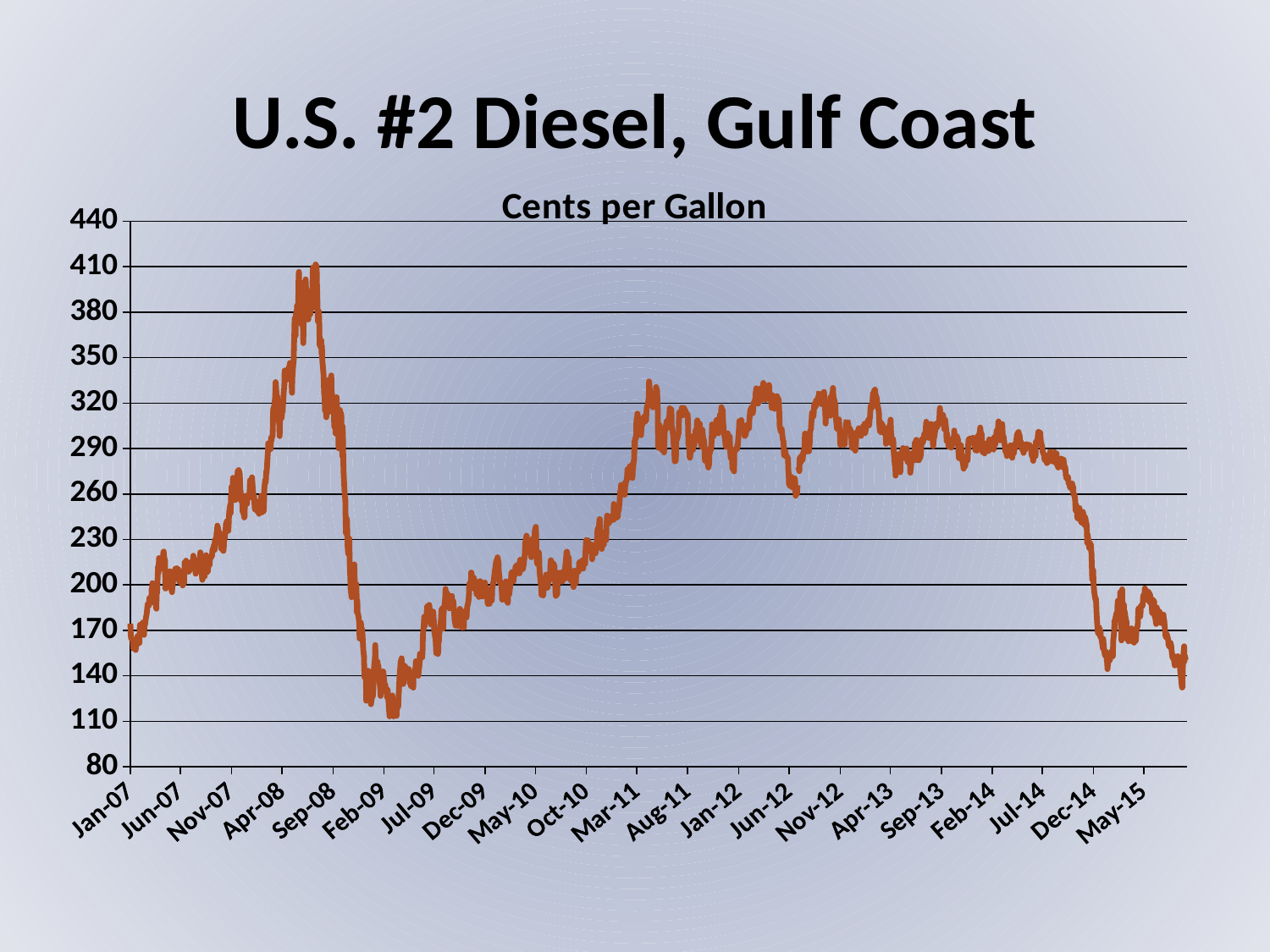
Is the peak value reached around Sep-08 greater or less than 380? greater What type of chart is shown on the slide? line chart Near which x-axis label does the line reach its lowest point? Feb-09 In what units are the values on the chart expressed? Cents per Gallon What is the title of the chart? U.S. #2 Diesel, Gulf Coast How many lines (data series) are plotted on the chart? 1 Is the lowest value reached in early 2009 greater or less than 140? less Is the value at Jan-12 greater or less than 260? greater Which is higher, the peak around Sep-08 or the peak around Aug-11? Sep-08 Near which x-axis label does the line reach its highest point? Sep-08 Does the line rise or fall between Jan-07 and Sep-08? rise